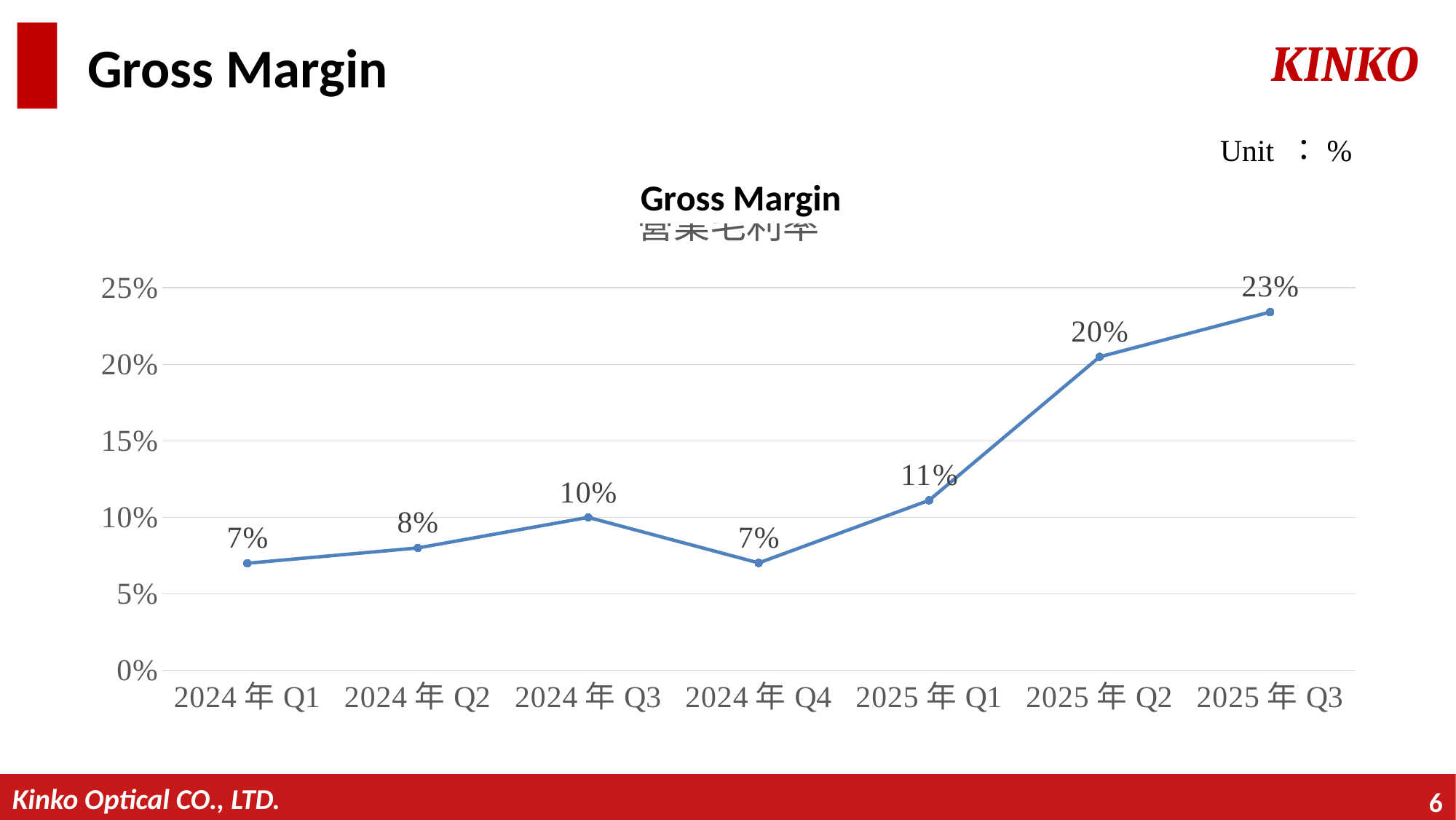
How many quarters are plotted on the chart? 7 Which quarter has the highest gross margin? 2025 年 Q3 What is the gross margin for 2025 年 Q1? 11% What is the difference in gross margin between 2025 年 Q2 and 2025 年 Q1? 9% What kind of chart is shown on the slide? line chart Which is larger, the gross margin for 2024 年 Q2 or for 2024 年 Q4? 2024 年 Q2 Does the gross margin rise or fall from 2024 年 Q4 to 2025 年 Q3? rise What is the gross margin for 2025 年 Q3? 23% Is the gross margin for 2025 年 Q2 greater or less than 15%? greater What is the title of the chart? Gross Margin What is the gross margin for 2024 年 Q3? 10% What is the difference in gross margin between 2024 年 Q3 and 2024 年 Q4? 3%